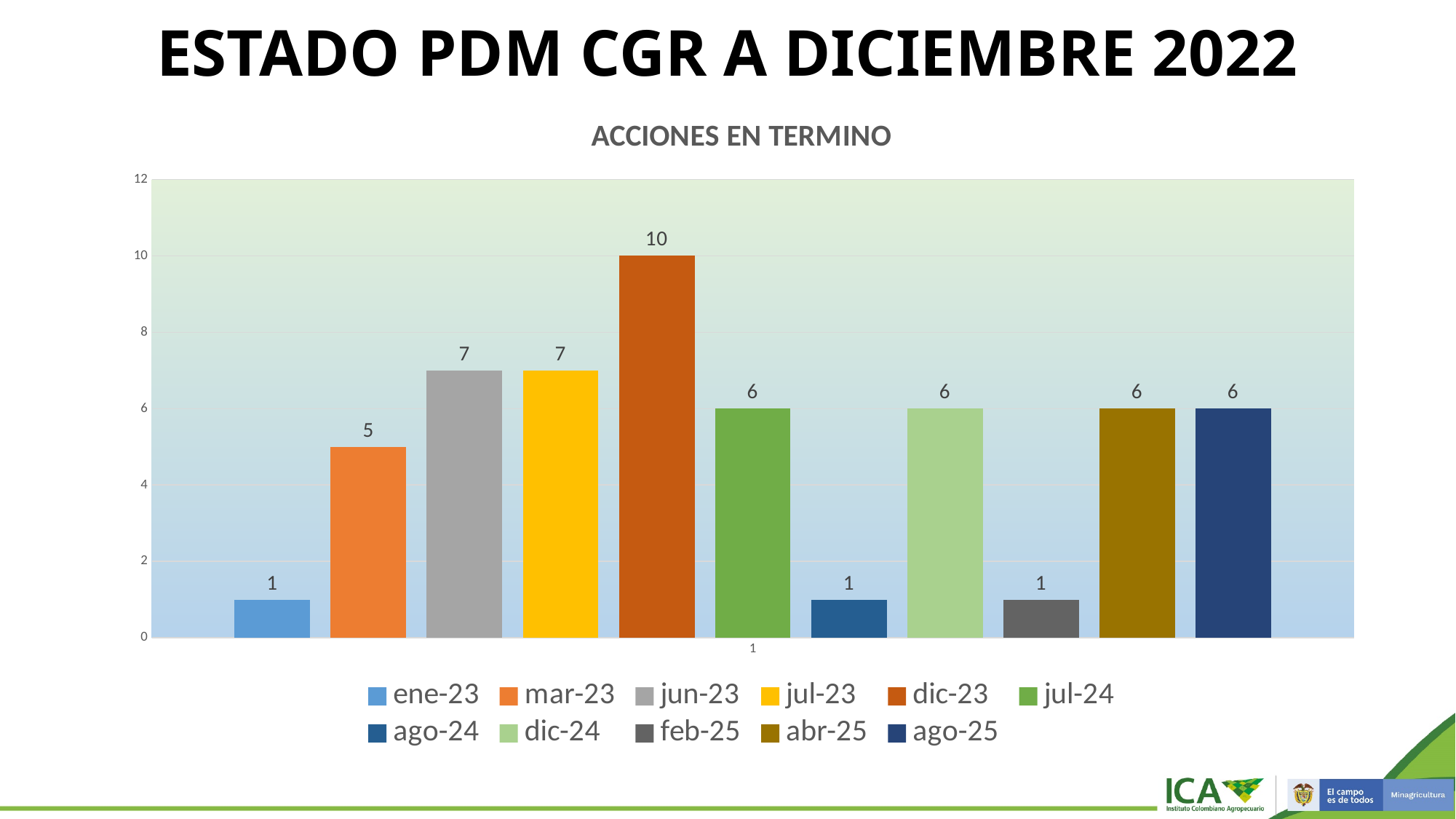
What is the value for feb-25? 1 What is the difference between the values for dic-23 and mar-23? 5 How many series does the legend list? 11 What is the title of the chart? ACCIONES EN TERMINO Which is larger, the value for jun-23 or the value for jul-24? jun-23 What is the value for mar-23? 5 What is the difference between the values for jul-23 and ene-23? 6 What is the value for dic-23? 10 What is the value for jun-23? 7 What kind of chart is shown on the slide? Bar chart Which series has the highest value? dic-23 Which is larger, the value for mar-23 or the value for abr-25? abr-25